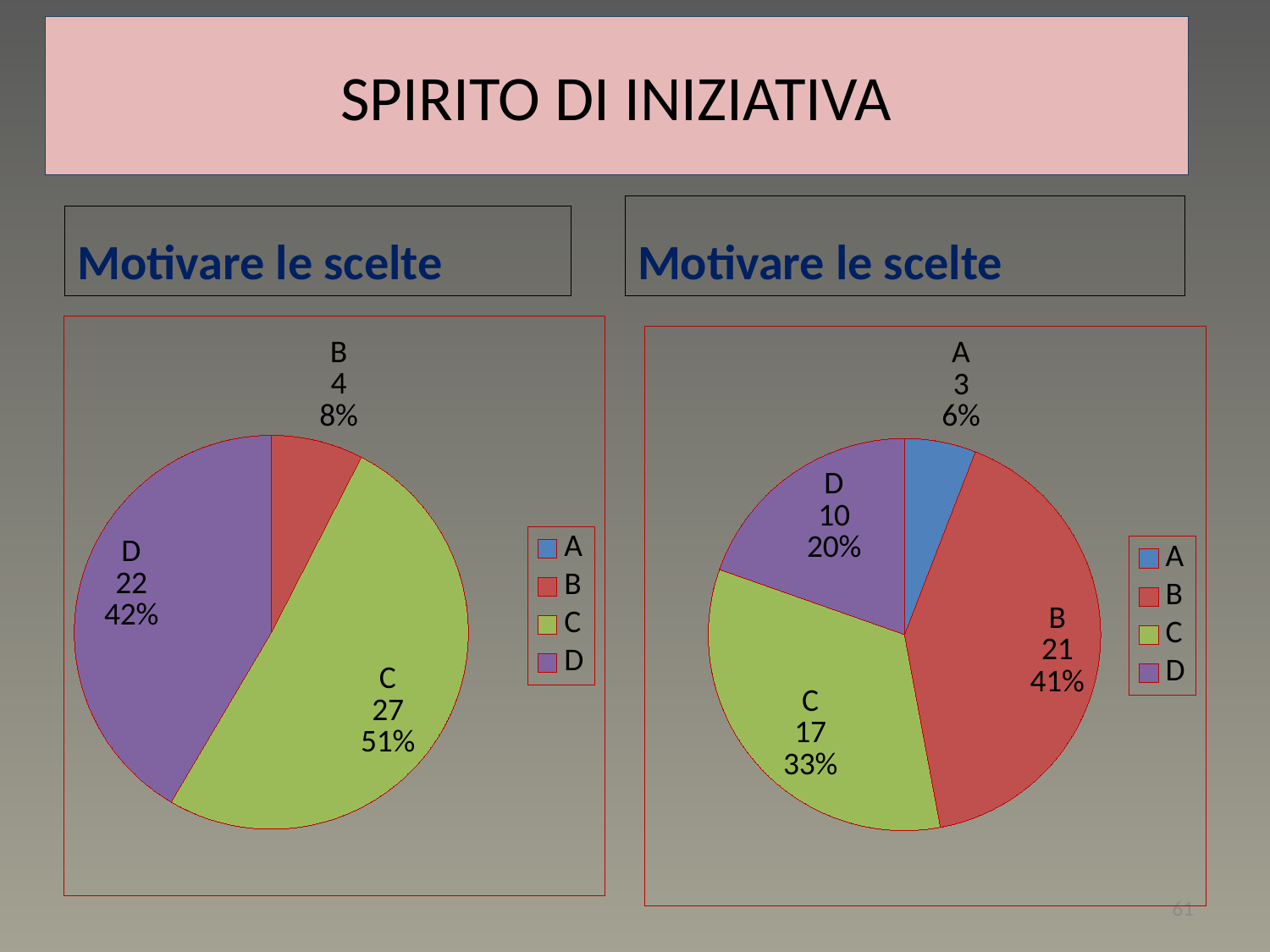
In the right pie chart, which category has the smallest slice? A In the left pie chart, what is the value for category C? 27 In the left pie chart, which category has the smallest slice? B In the left pie chart, what is the difference between the values for C and D? 5 In the right pie chart, what percentage share does category C have? 33% In the right pie chart, what is the value for category B? 21 In the right pie chart, what is the difference between the values for B and D? 11 What kind of chart is shown on the left of the slide? Pie chart In the left pie chart, which category has the largest slice? C How many series does the legend of the right chart list? 4 In the right pie chart, which is larger, the value for C or the value for D? C In the left pie chart, what percentage share does category D have? 42%